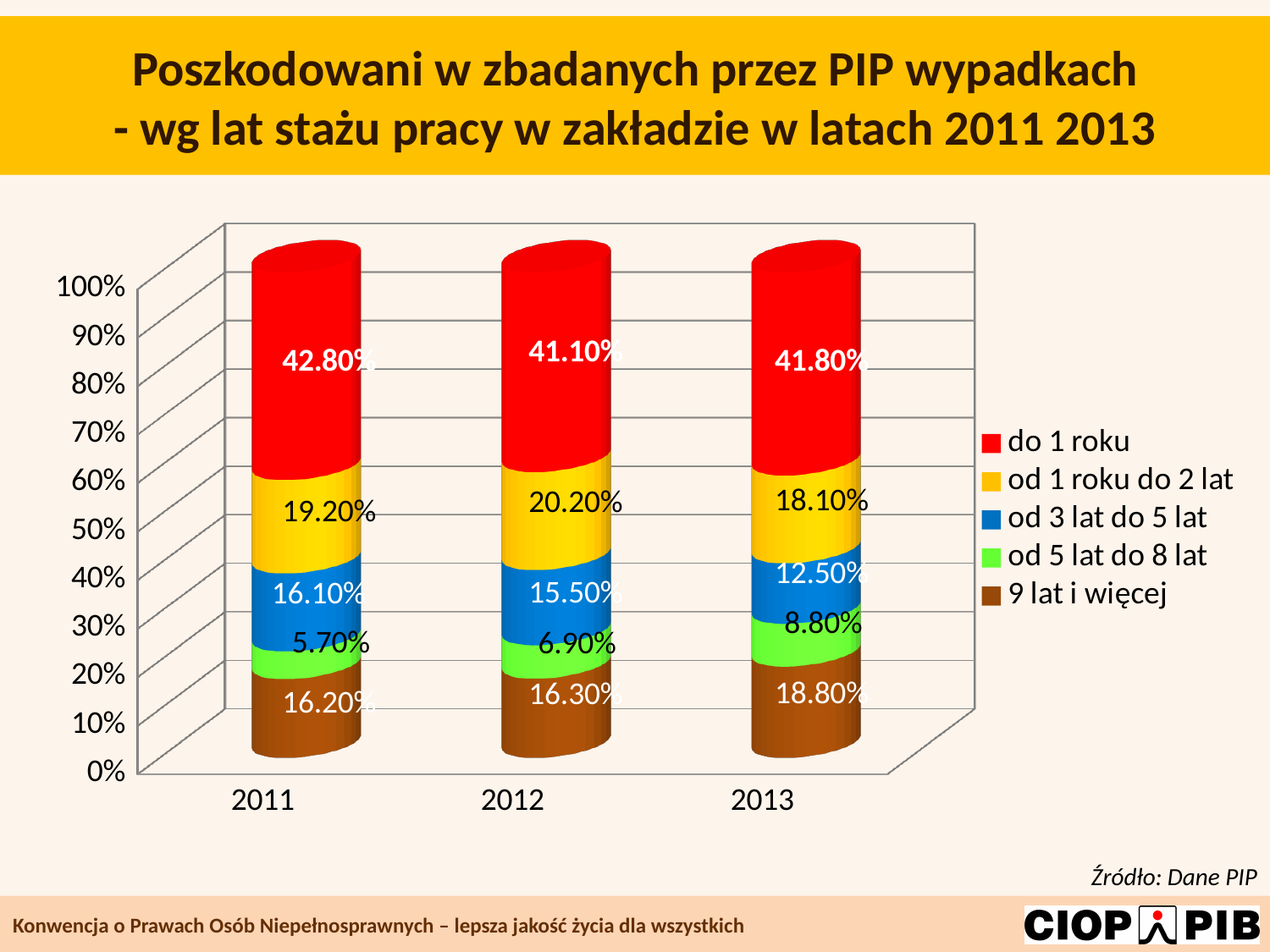
What kind of chart is shown on the slide? Stacked bar chart What is the value for "od 1 roku do 2 lat" in 2012? 20.20% What is the value for "do 1 roku" in 2011? 42.80% Does the value for "od 3 lat do 5 lat" rise or fall from 2011 to 2013? Fall How many series does the legend list? 5 Which year has the larger value for "od 1 roku do 2 lat": 2011 or 2013? 2011 In which year is the share for "do 1 roku" the highest? 2011 What is the value for "9 lat i więcej" in 2013? 18.80% What is the value for "od 5 lat do 8 lat" in 2013? 8.80% How many years are shown on the x axis? 3 In which year is the share for "od 5 lat do 8 lat" the lowest? 2011 What is the difference between the "od 3 lat do 5 lat" values for 2012 and 2013? 3.00%